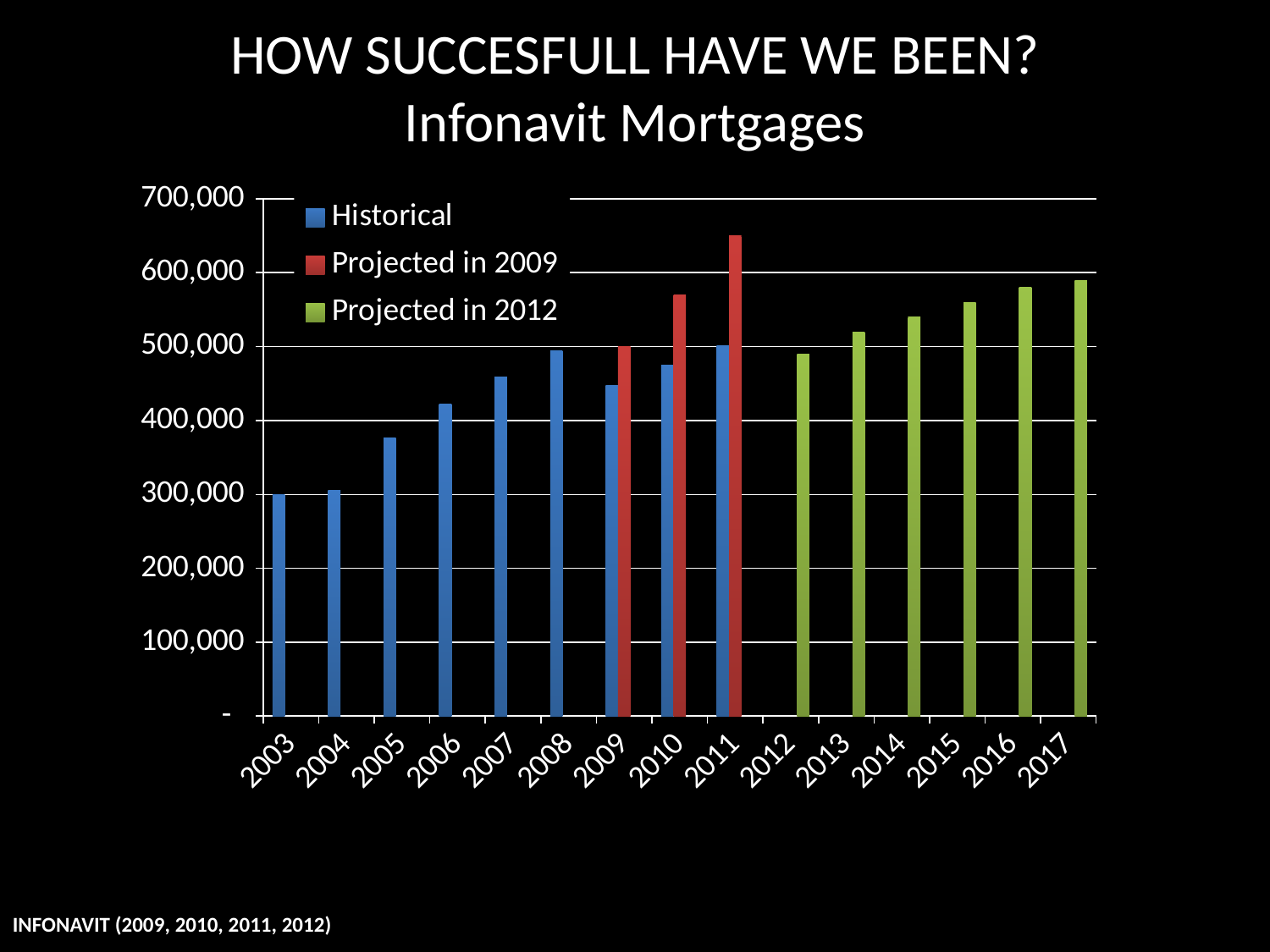
How many years are shown on the x axis? 15 Do the Projected in 2012 values rise or fall from 2012 to 2017? rise Is the Historical value for 2005 greater or less than 400,000? less Is the Projected in 2009 value for 2010 greater or less than 500,000? greater In which year is the Projected in 2009 series highest? 2011 In which year is the Projected in 2012 series lowest? 2012 What colour represents the Historical series in the legend? blue For 2009, which is larger: the Historical value or the Projected in 2009 value? Projected in 2009 How many series does the legend list? 3 What kind of chart is shown on the slide? bar chart Is the Historical value for 2006 greater or less than 400,000? greater